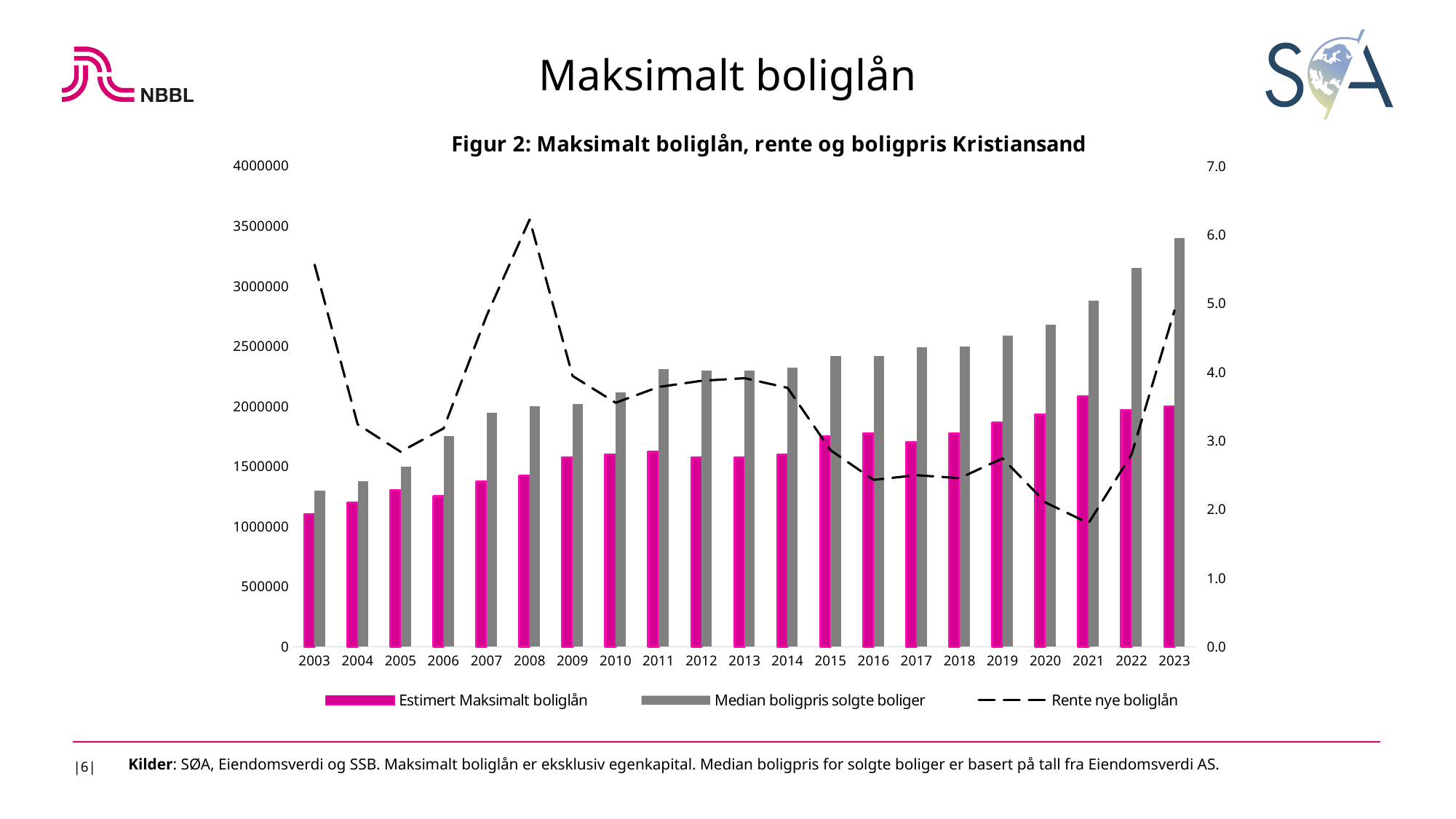
In which year does Rente nye boliglån reach its highest value? 2008 What is the title of the chart? Figur 2: Maksimalt boliglån, rente og boligpris Kristiansand Which series is drawn as a dashed line? Rente nye boliglån What kind of chart is shown on the slide? Combined bar and line chart How many years are shown on the x axis? 21 In which year is Rente nye boliglån at its lowest? 2021 Is the value for Median boligpris solgte boliger in 2023 greater or less than 3000000? greater Is the value for Estimert Maksimalt boliglån in 2003 greater or less than 1500000? less How many series does the legend list? 3 Which is larger in 2023: Estimert Maksimalt boliglån or Median boligpris solgte boliger? Median boligpris solgte boliger In which year is Estimert Maksimalt boliglån lowest? 2003 In which year is Median boligpris solgte boliger highest? 2023